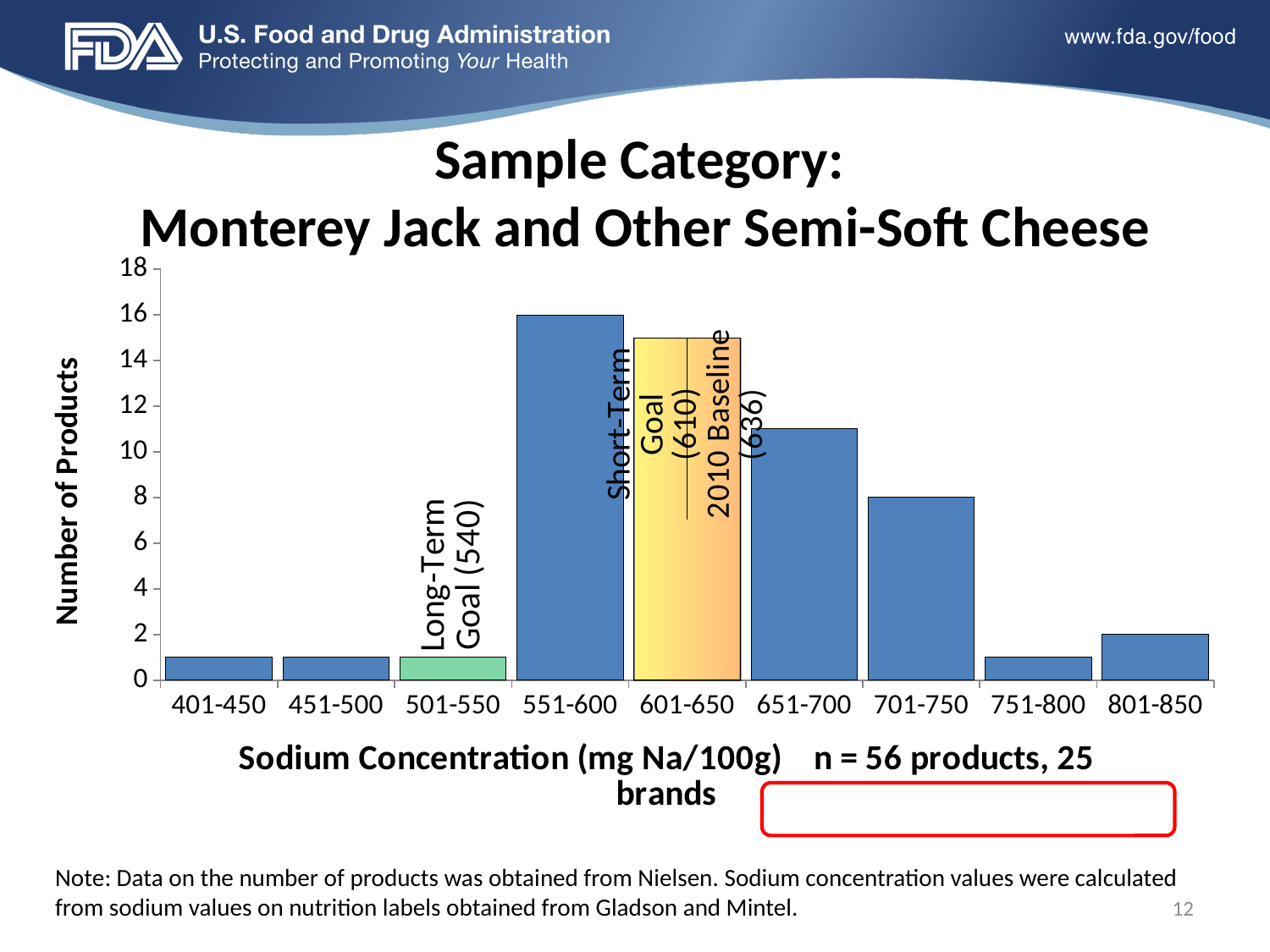
Which has more products, the 601-650 category or the 651-700 category? 601-650 How many sodium concentration categories are shown on the x axis? 9 What is the number of products in the 701-750 category? 8 Which sodium concentration category has the highest number of products? 551-600 Is the number of products in the 401-450 category greater or less than 2? less What is the title of the y axis? Number of Products What type of chart is shown on the slide? bar chart What is the number of products in the 551-600 category? 16 What is the difference in number of products between the 551-600 and 701-750 categories? 8 What is the number of products in the 801-850 category? 2 Is the number of products in the 601-650 category greater or less than 14? greater Do the number of products rise or fall along the x axis from the 551-600 category to the 801-850 category? fall